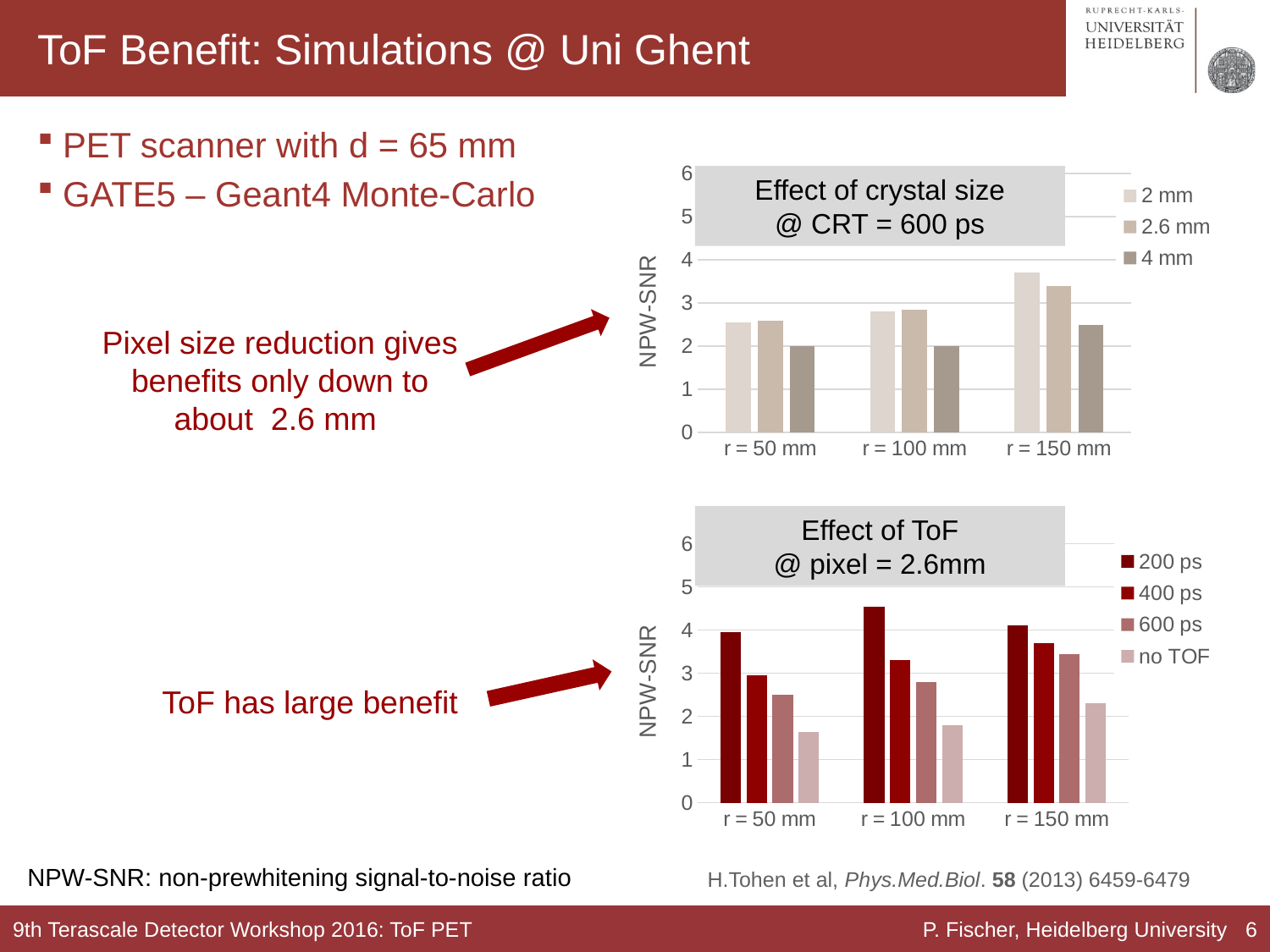
In the 'Effect of ToF @ pixel = 2.6mm' chart, is the value for 200 ps at r = 100 mm greater or less than 4? greater What kind of chart is the 'Effect of crystal size @ CRT = 600 ps' chart? bar chart How many series does the legend of the 'Effect of ToF @ pixel = 2.6mm' chart list? 4 In the 'Effect of ToF @ pixel = 2.6mm' chart, which series has the lowest value at r = 50 mm? no TOF In the 'Effect of ToF @ pixel = 2.6mm' chart, which category has the highest 200 ps bar? r = 100 mm In the 'Effect of crystal size @ CRT = 600 ps' chart, is the value for 4 mm at r = 50 mm greater or less than 3? less What is the y-axis label of the 'Effect of ToF @ pixel = 2.6mm' chart? NPW-SNR How many categories are shown on the x axis of the 'Effect of crystal size @ CRT = 600 ps' chart? 3 How many series does the legend of the 'Effect of crystal size @ CRT = 600 ps' chart list? 3 In the 'Effect of crystal size @ CRT = 600 ps' chart, at r = 150 mm, which is larger: the 2 mm bar or the 4 mm bar? 2 mm In the 'Effect of crystal size @ CRT = 600 ps' chart, is the value for 2 mm at r = 150 mm greater or less than 3? greater In the 'Effect of ToF @ pixel = 2.6mm' chart, do the no TOF values rise or fall from r = 50 mm to r = 150 mm? rise